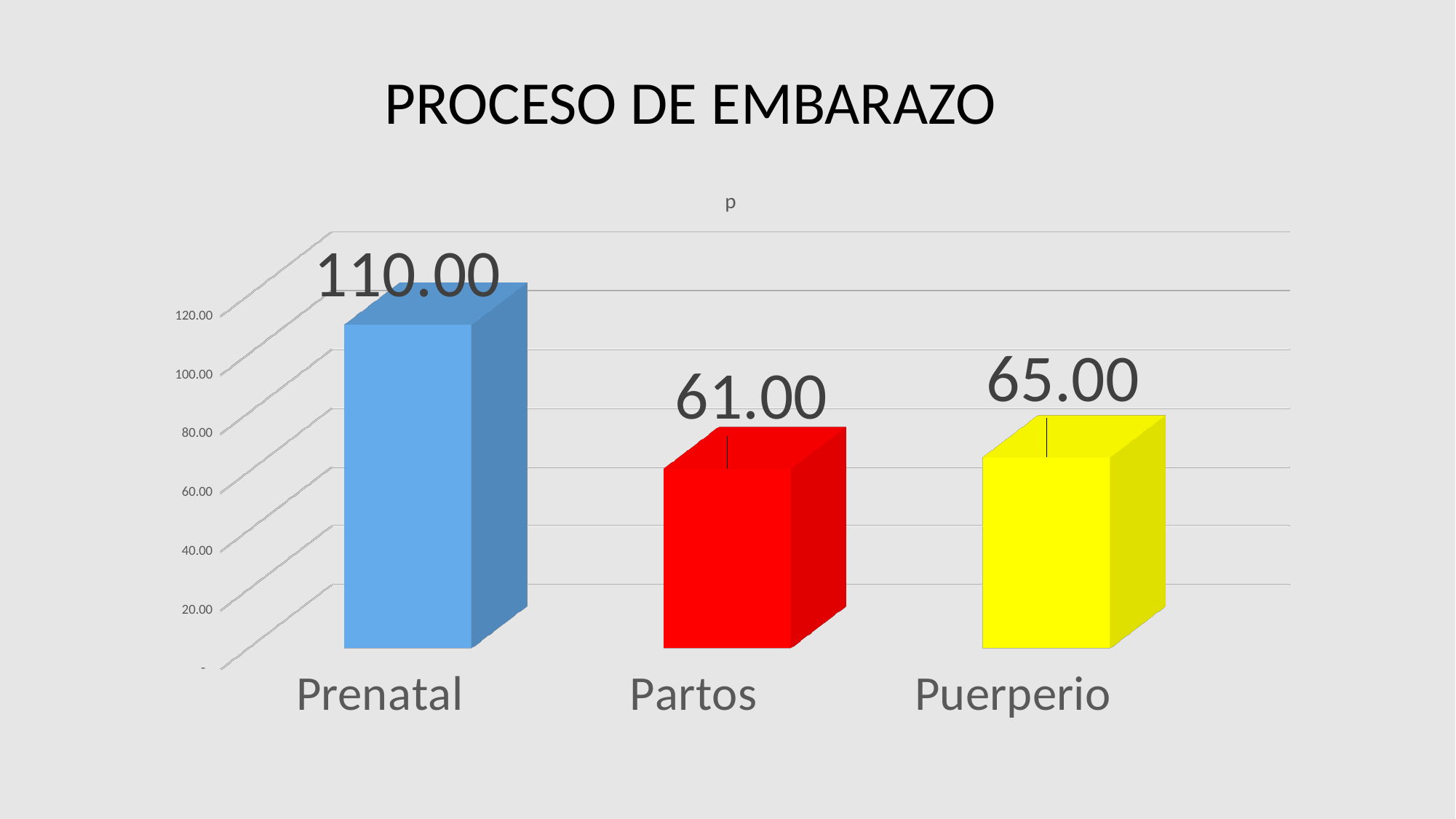
What is the difference between the values for Puerperio and Partos? 4.00 What is the value for Partos? 61.00 What is the value for Prenatal? 110.00 Which is larger, the value for Prenatal or the value for Puerperio? Prenatal What kind of chart is shown on the slide? bar chart How many categories are shown on the x axis? 3 Which category has the highest value? Prenatal What is the title of the slide? PROCESO DE EMBARAZO What is the value for Puerperio? 65.00 Which category has the lowest value? Partos What is the difference between the values for Prenatal and Partos? 49.00 Is the value for Partos greater or less than 80.00? less